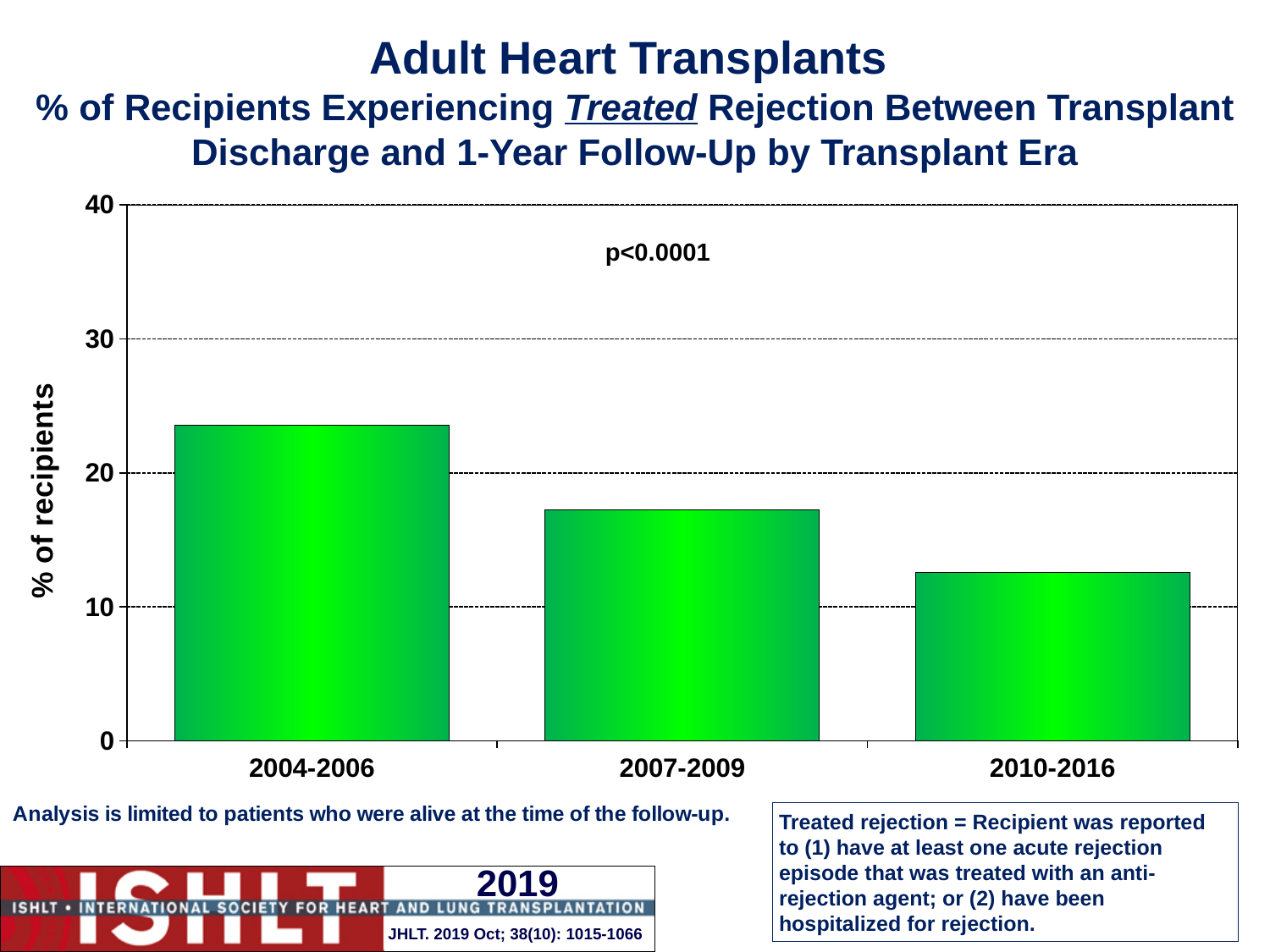
Is the value for 2004-2006 greater or less than 30? less Which transplant era has the highest % of recipients experiencing treated rejection? 2004-2006 Do the values rise or fall across the transplant eras from 2004-2006 to 2010-2016? fall What is the label on the y axis? % of recipients What kind of chart is shown on the slide? bar chart Is the value for 2004-2006 greater or less than 20? greater What p-value is printed on the chart? p<0.0001 How many transplant eras are shown on the x axis? 3 Is the value for 2010-2016 greater or less than 10? greater Which is larger, the value for 2007-2009 or the value for 2010-2016? 2007-2009 Which transplant era has the lowest % of recipients experiencing treated rejection? 2010-2016